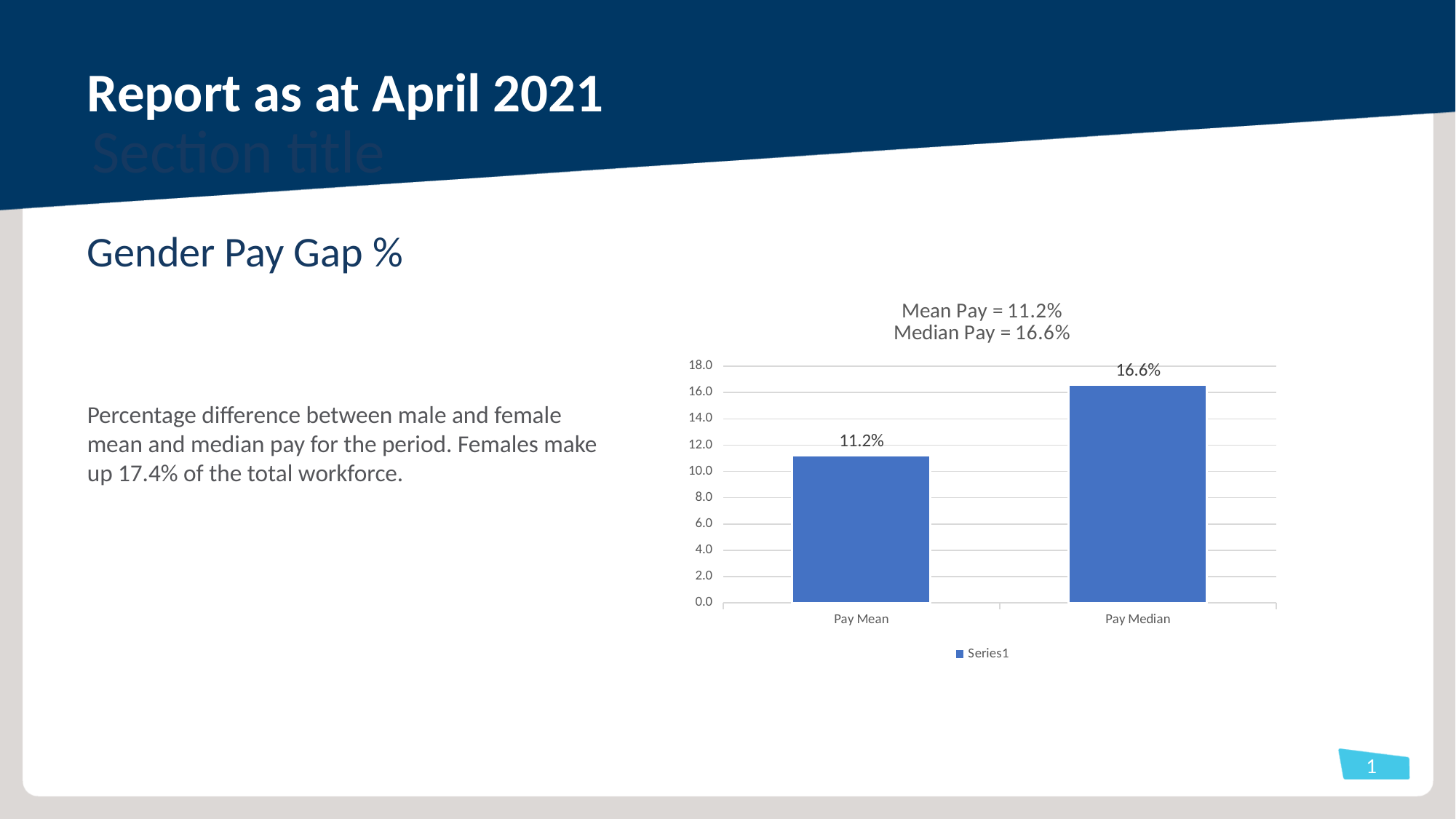
How many categories are shown on the x axis? 2 Which category has the highest value? Pay Median What is the difference between the Pay Median and Pay Mean values? 5.4% What is the value for Pay Mean? 11.2% What is the name of the series shown in the legend? Series1 Is the value for Pay Mean greater or less than 12.0? less Which is larger, Pay Mean or Pay Median? Pay Median Is the value for Pay Median greater or less than 14.0? greater Which category has the lowest value? Pay Mean What kind of chart is shown? Bar chart What is the value for Pay Median? 16.6% How many series does the legend list? 1